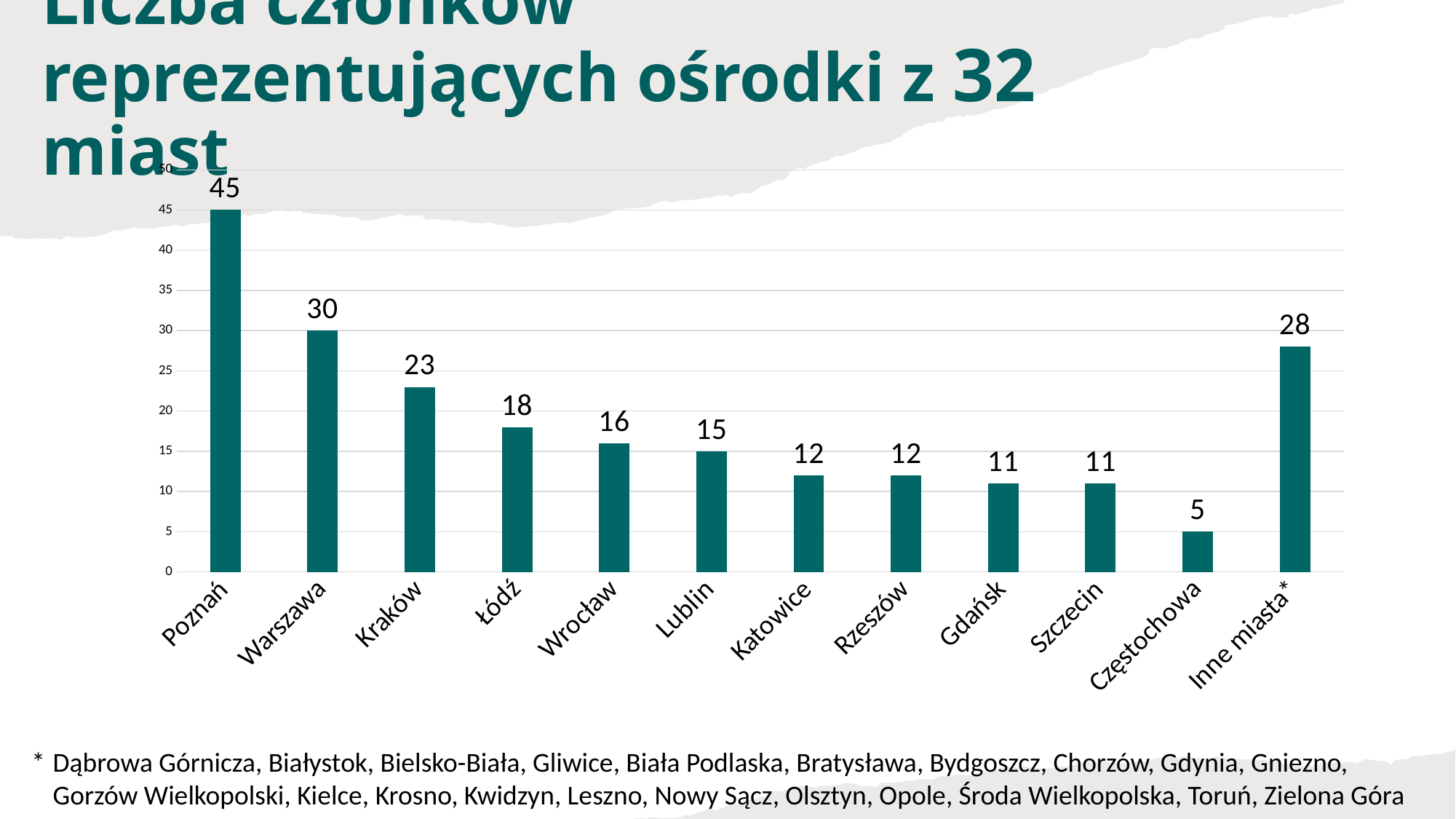
What is the value for Poznań? 45 What is the value for Kraków? 23 What is the value for Szczecin? 11 What is the value for Inne miasta*? 28 What is the difference between the values for Inne miasta* and Częstochowa? 23 What is the difference between the values for Poznań and Warszawa? 15 How many categories are shown on the x axis? 12 What kind of chart is shown on the slide? bar chart Is the value for Lublin greater or less than 20? less Which city has the highest value? Poznań Which is larger, the value for Łódź or the value for Wrocław? Łódź Which category has the lowest value? Częstochowa